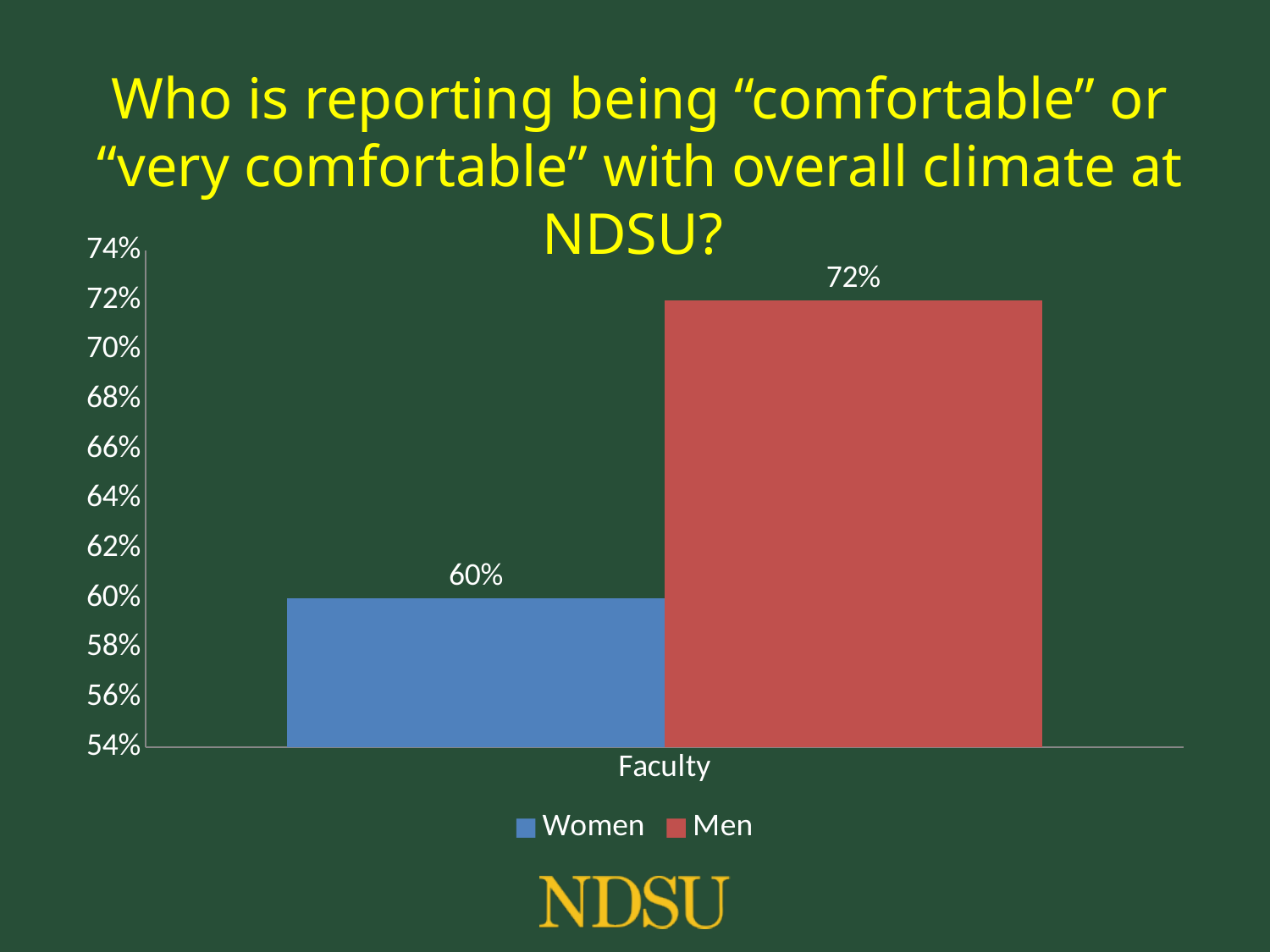
What percentage of women faculty report being comfortable or very comfortable with the overall climate at NDSU? 60% Which series has the lowest value on the chart? Women How many series does the legend list? 2 What kind of chart is shown on the slide? Bar chart Which colour represents Men in the legend? Red What is the category label on the x axis? Faculty Which series has the higher value for Faculty, Women or Men? Men How many categories are shown on the x axis? 1 What percentage of men faculty report being comfortable or very comfortable with the overall climate at NDSU? 72% What is the difference in percentage points between the Men and Women values for Faculty? 12 Is the value for Women greater or less than 64%? less Is the value for Men greater or less than 70%? greater